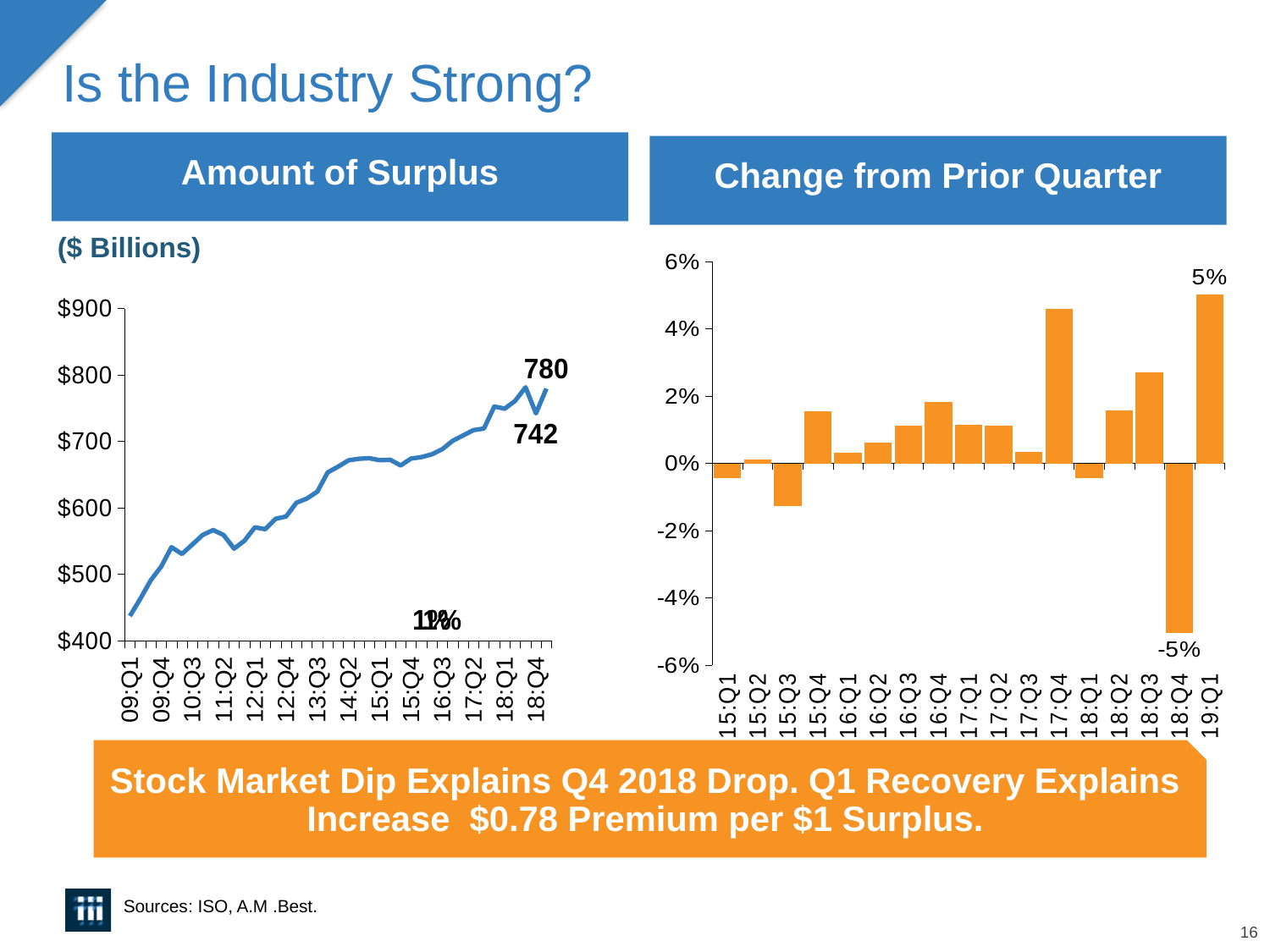
In the Amount of Surplus chart, what is the difference between the two labeled values, 780 and 742? 38 In the Change from Prior Quarter chart, what is the value for 18:Q4? -5% What kind of chart is the Change from Prior Quarter chart? bar chart In the Change from Prior Quarter chart, what is the value for 19:Q1? 5% In the Amount of Surplus chart, is the value for 09:Q1 greater or less than $500? less In the Amount of Surplus chart, does the surplus generally rise or fall from 09:Q1 to 18:Q4? rise How many quarters are shown on the x axis of the Change from Prior Quarter chart? 17 What kind of chart is the Amount of Surplus chart? line chart In the Change from Prior Quarter chart, which quarter has the highest value? 19:Q1 In the Change from Prior Quarter chart, is the value for 17:Q4 greater or less than 4%? greater In the Change from Prior Quarter chart, which is larger, the value for 17:Q4 or the value for 18:Q3? 17:Q4 In the Change from Prior Quarter chart, which quarter has the lowest value? 18:Q4